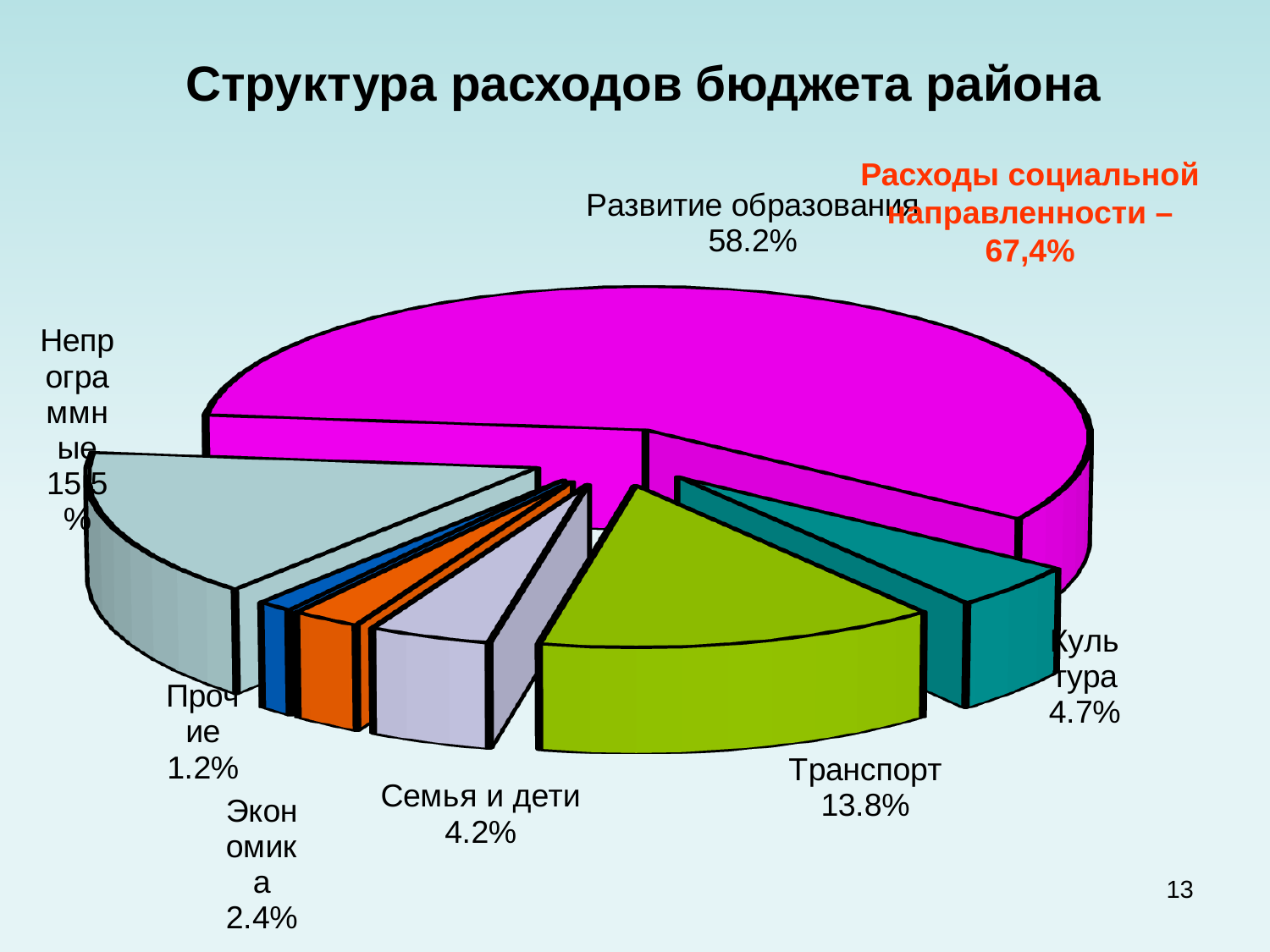
Which category has the largest share of the pie? Развитие образования What share of the budget expenditure goes to Культура? 4.7% What share of the budget expenditure goes to Семья и дети? 4.2% What share of the budget expenditure goes to Развитие образования? 58.2% What share of the budget expenditure goes to Экономика? 2.4% Which category has the smallest share of the pie? Прочие What kind of chart is shown on the slide? pie chart Which is larger, the share for Культура or the share for Семья и дети? Культура What share of the budget expenditure goes to Транспорт? 13.8% What is the difference in percentage points between Развитие образования and Транспорт? 44.4 What is the title of the chart? Структура расходов бюджета района How many slices does the pie chart have? 7